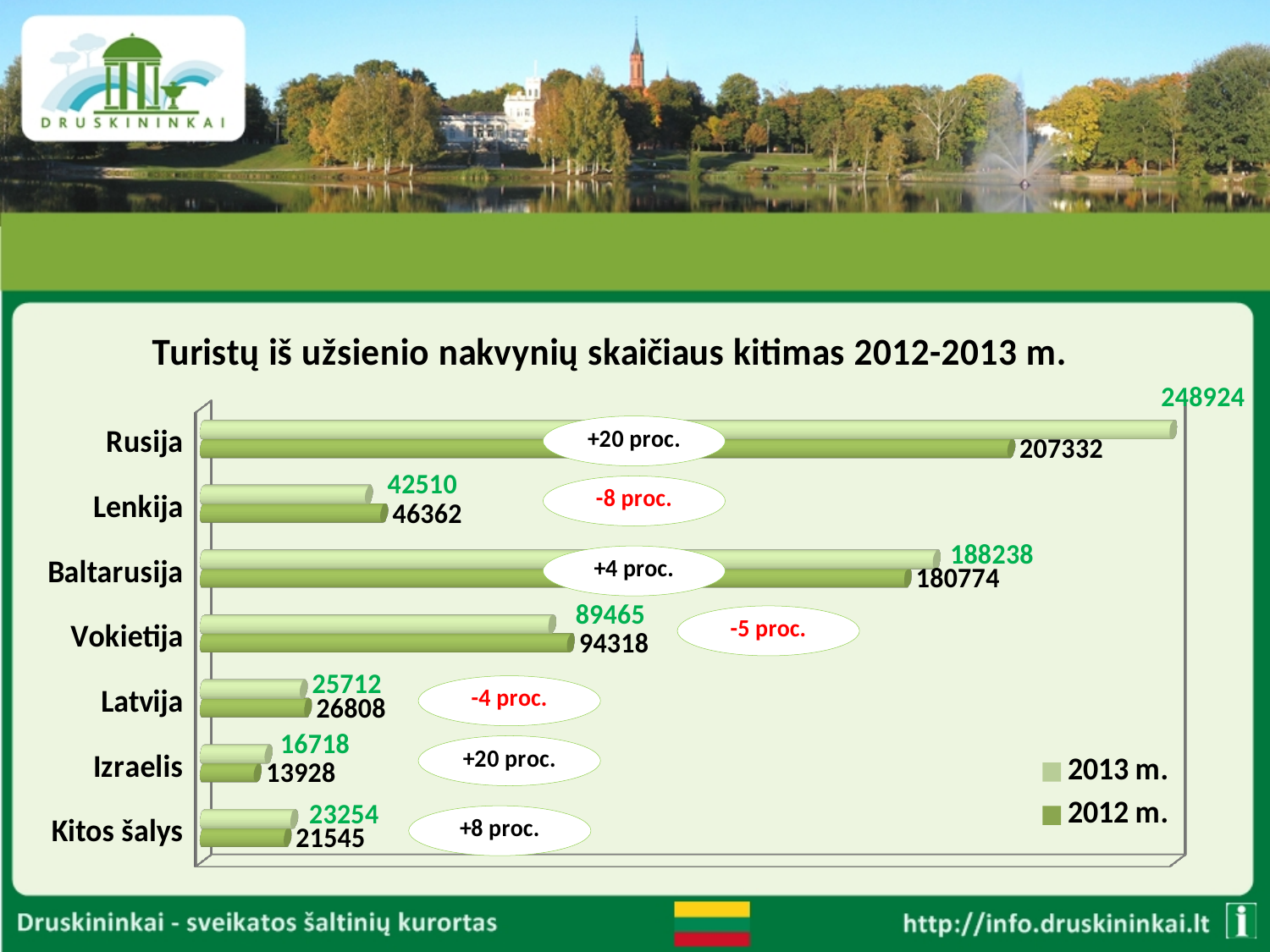
What is the 2013 m. value for Izraelis? 16718 Which category has the lowest 2012 m. value? Izraelis Which is larger for Baltarusija, the 2013 m. value or the 2012 m. value? 2013 m. What is the 2012 m. value for Kitos šalys? 21545 What is the 2013 m. value for Rusija? 248924 What is the difference between the 2013 m. and 2012 m. values for Rusija? 41592 How many series does the legend list? 2 Which category has the highest 2013 m. value? Rusija What kind of chart is shown on the slide? Bar chart How many categories are shown in the chart? 7 What is the difference between the 2012 m. and 2013 m. values for Lenkija? 3852 What is the 2012 m. value for Vokietija? 94318